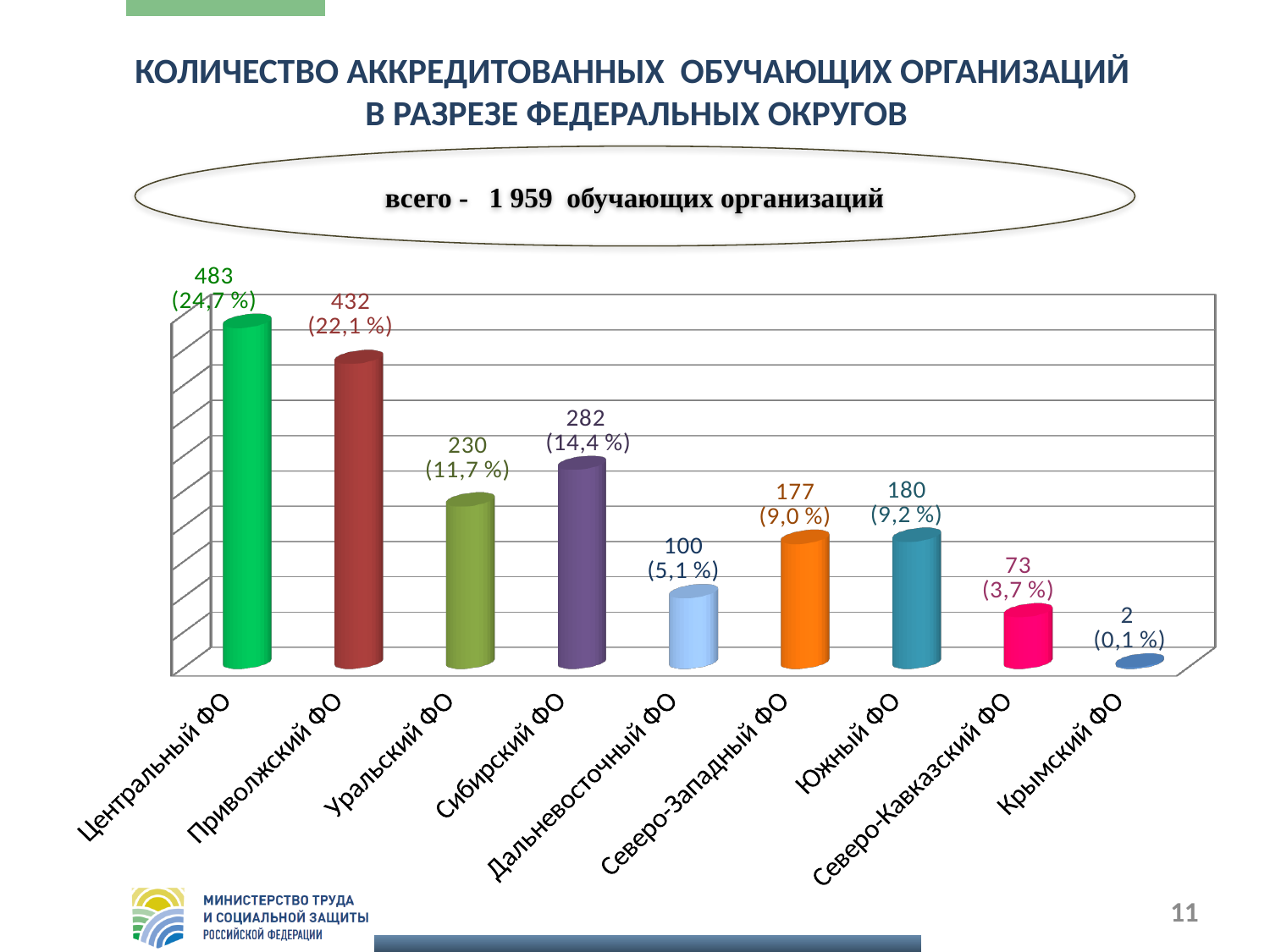
What is the value for Сибирский ФО? 282 What total number of training organisations is stated on the slide? 1 959 What percentage share is shown for Приволжский ФО? 22,1 % What kind of chart is shown on the slide? Bar chart How many federal districts are shown on the chart? 9 What is the difference between the values for Центральный ФО and Приволжский ФО? 51 Which federal district has the highest value? Центральный ФО What is the value for Дальневосточный ФО? 100 Which federal district has the lowest value? Крымский ФО What is the value for Центральный ФО? 483 What is the difference between the values for Сибирский ФО and Уральский ФО? 52 Which is larger, the value for Уральский ФО or the value for Северо-Западный ФО? Уральский ФО